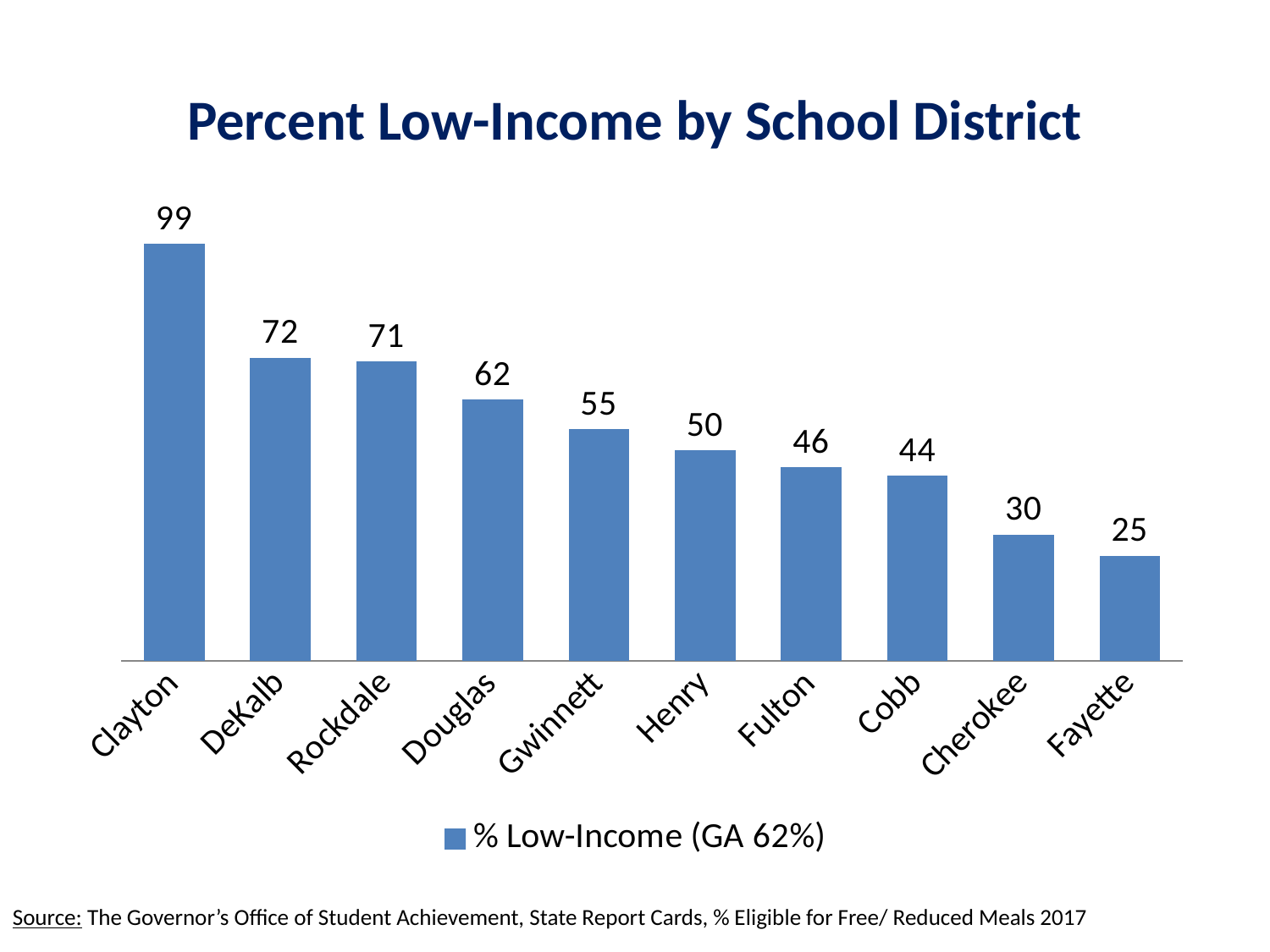
What is the percent low-income value for Clayton? 99 What kind of chart is shown on the slide? Bar chart What is the percent low-income value for Cherokee? 30 How many series does the legend list? 1 Which school district has the lowest percent low-income? Fayette Which has a larger percent low-income, Henry or Cobb? Henry What is the difference between the values for Clayton and Fayette? 74 What is the percent low-income value for Gwinnett? 55 What is the title of the chart? Percent Low-Income by School District What is the difference between the values for DeKalb and Douglas? 10 How many school districts are shown in the chart? 10 Which school district has the highest percent low-income? Clayton